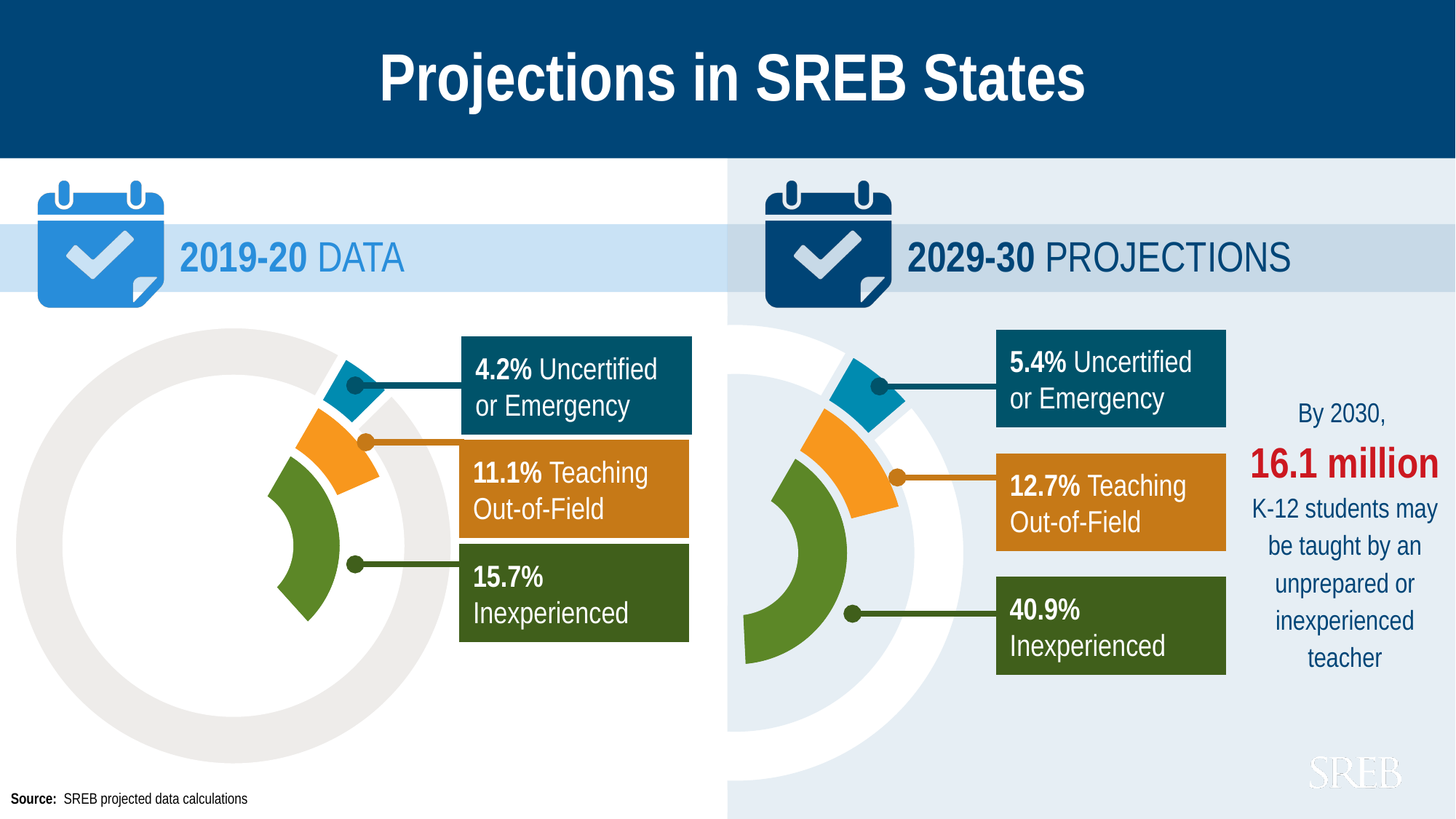
In the 2019-20 DATA chart, which category has the lowest value? Uncertified or Emergency In the 2019-20 DATA chart, what is the value for Uncertified or Emergency? 4.2% In the 2029-30 PROJECTIONS chart, which category has the highest value? Inexperienced In the 2019-20 DATA chart, what is the value for Inexperienced? 15.7% In the 2029-30 PROJECTIONS chart, what is the value for Inexperienced? 40.9% What is the difference between the Inexperienced value in the 2029-30 PROJECTIONS chart and the Inexperienced value in the 2019-20 DATA chart? 25.2% In the 2029-30 PROJECTIONS chart, what is the value for Uncertified or Emergency? 5.4% How many categories are shown in the 2019-20 DATA chart? 3 In the 2019-20 DATA chart, what is the value for Teaching Out-of-Field? 11.1% In the 2029-30 PROJECTIONS chart, what is the value for Teaching Out-of-Field? 12.7% What colour is the Inexperienced segment in the 2029-30 PROJECTIONS chart? Green Which is larger: Teaching Out-of-Field in the 2019-20 DATA chart or Teaching Out-of-Field in the 2029-30 PROJECTIONS chart? 2029-30 PROJECTIONS